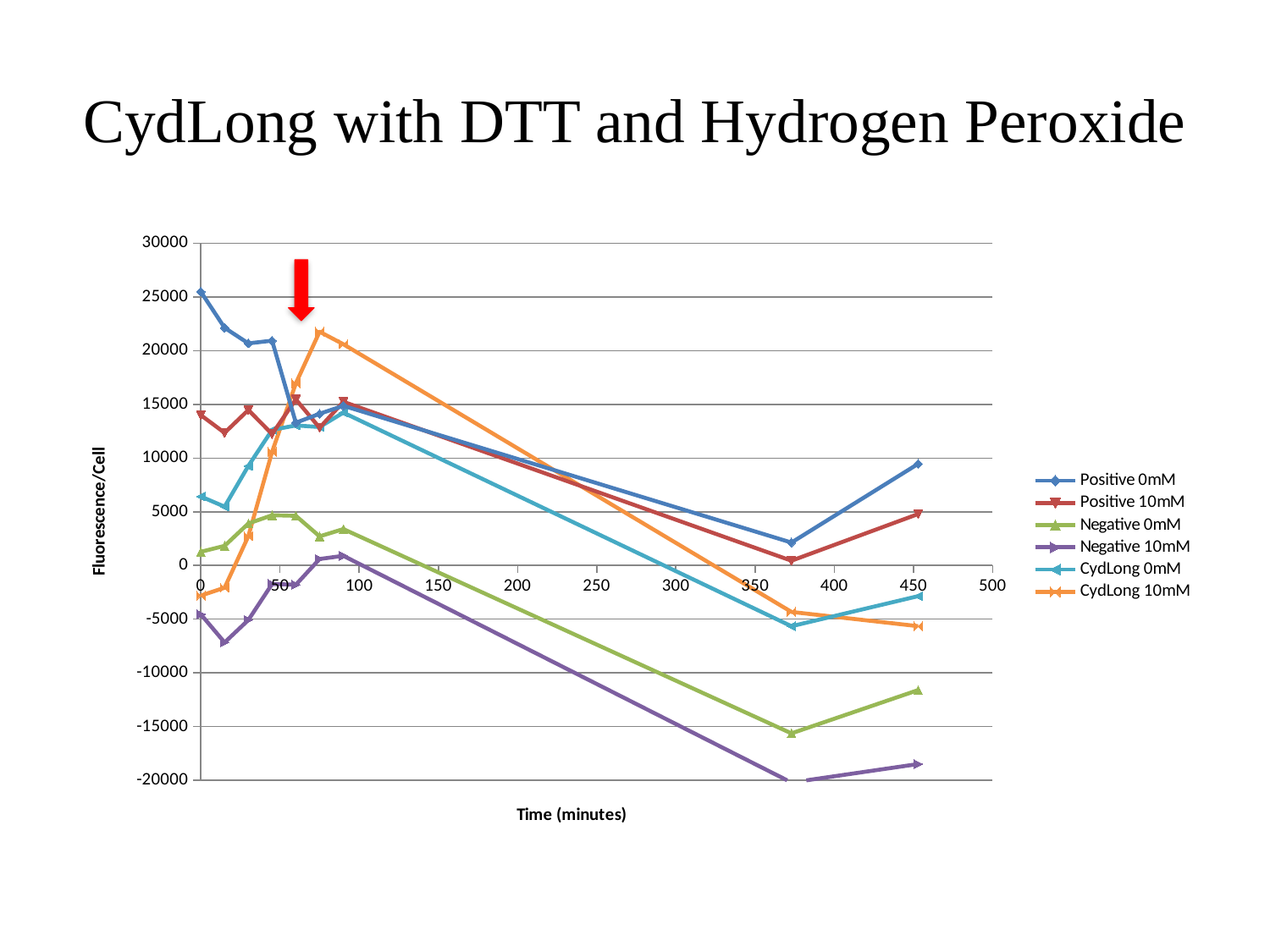
Is the peak value of CydLong 10mM (around 75 minutes) greater or less than 20000? greater What is the title of the x axis? Time (minutes) Is the value for Positive 0mM at time 0 greater or less than 20000? greater What is the title of the y axis? Fluorescence/Cell Which series has the highest value at time 0? Positive 0mM Which series has the lowest value at around 375 minutes? Negative 10mM At around 450 minutes, which series has the larger value: Positive 0mM or Positive 10mM? Positive 0mM How many series does the legend list? 6 Is the value for Negative 0mM at around 375 minutes greater or less than -15000? less What kind of chart is shown on the slide? line chart